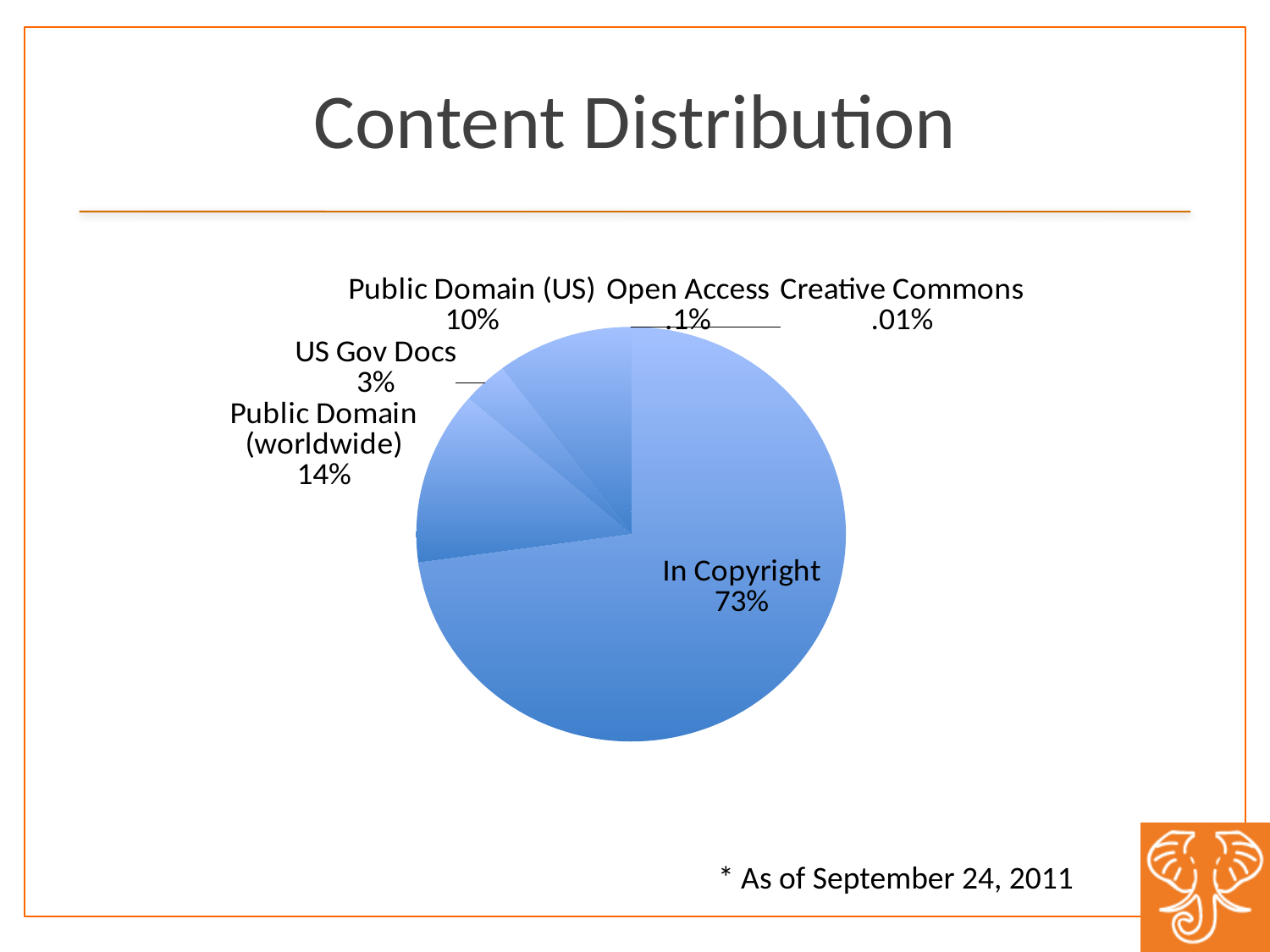
What share of the pie does In Copyright hold? 73% What is the value shown for Creative Commons? .01% How many categories are shown in the pie chart? 6 What kind of chart is shown on the slide? Pie chart Which category has the smallest slice of the pie? Creative Commons What is the value shown for Public Domain (worldwide)? 14% Which is larger, Public Domain (US) or US Gov Docs? Public Domain (US) What is the value shown for Open Access? .1% What is the value shown for US Gov Docs? 3% Which category has the largest slice of the pie? In Copyright What is the value shown for Public Domain (US)? 10% What is the difference between the In Copyright share and the Public Domain (worldwide) share? 59%